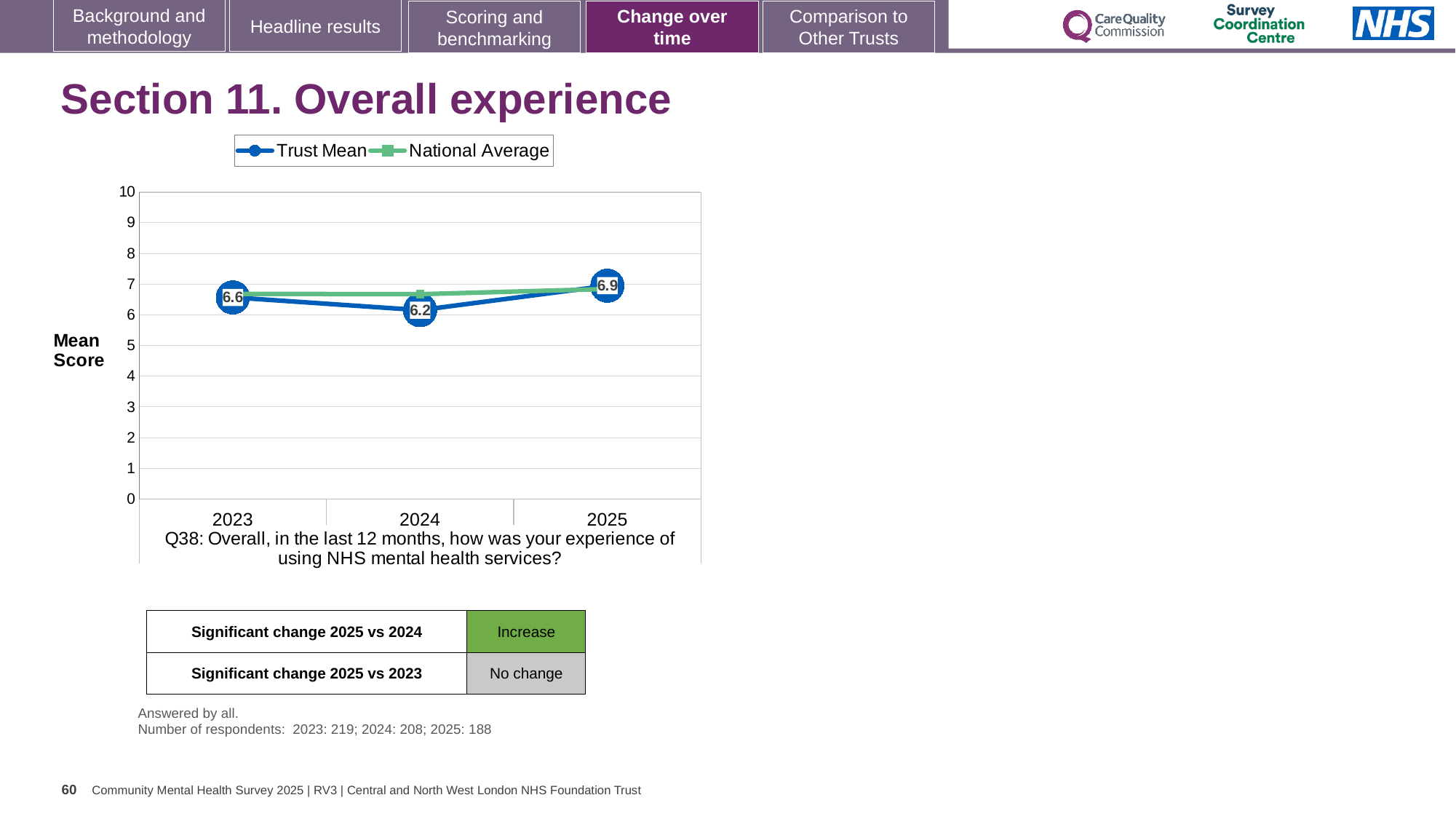
Which is larger, the Trust Mean score for 2023 or for 2024? 2023 What kind of chart is shown on the slide? Line chart What is the Trust Mean score for 2024? 6.2 What is the Trust Mean score for 2025? 6.9 Is the National Average value for 2024 greater or less than 5? greater Does the Trust Mean score rise or fall from 2024 to 2025? Rise What is the Trust Mean score for 2023? 6.6 How many years are shown on the x axis? 3 What is the difference between the Trust Mean scores for 2025 and 2024? 0.7 In which year is the Trust Mean score lowest? 2024 In which year is the Trust Mean score highest? 2025 How many series does the legend list? 2